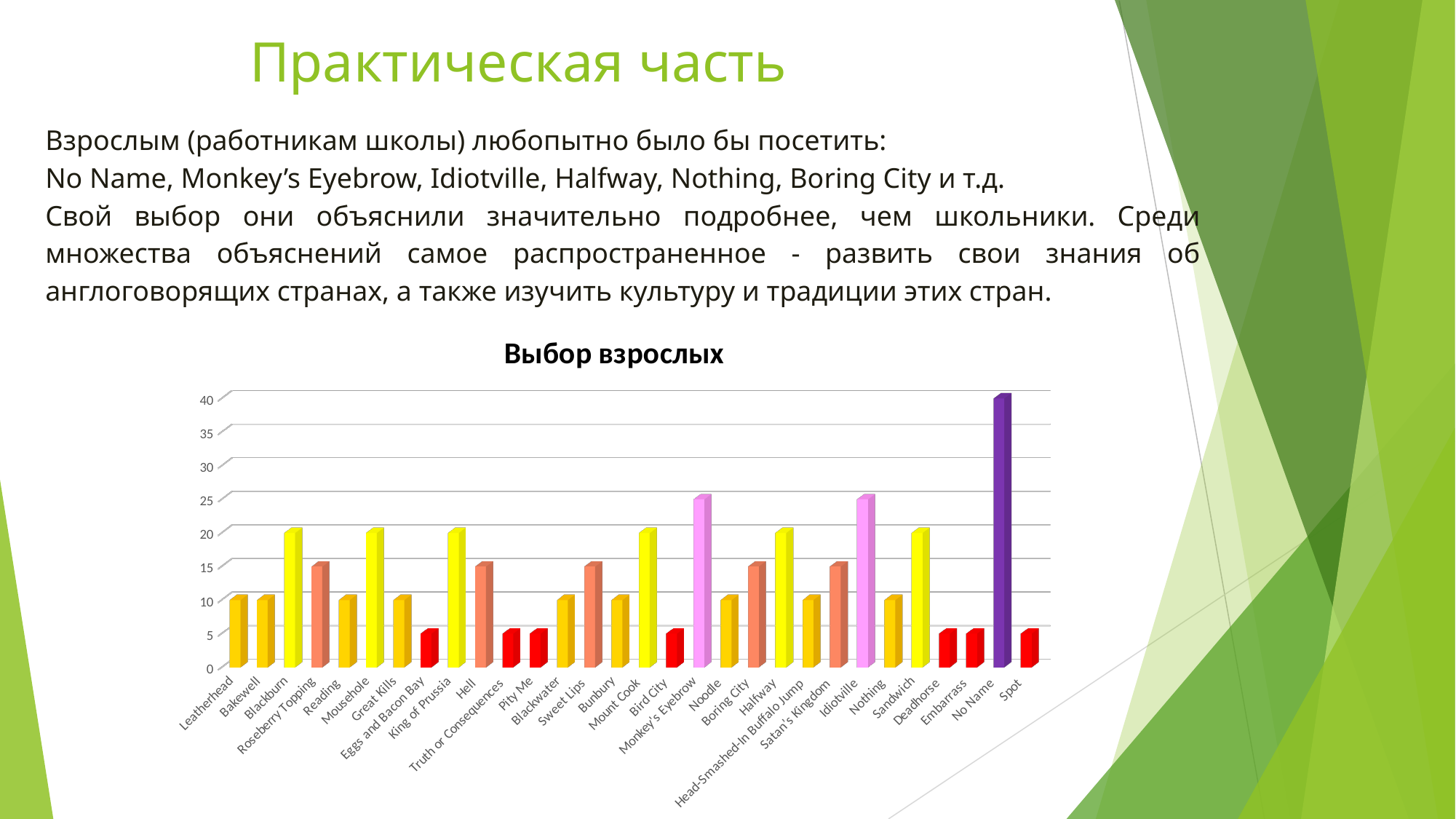
What is the value for Halfway? 20 What is the value for No Name? 40 What is the value for Hell? 15 What is the value for Monkey's Eyebrow? 25 Which category has the highest value in the chart? No Name How many categories are shown on the x axis of the chart? 30 What is the value for Idiotville? 25 What is the title of the chart on the slide? Выбор взрослых What kind of chart is shown on the slide? bar chart Is the value for Pity Me greater or less than 10? less Which is larger, the value for No Name or the value for Idiotville? No Name Is the value for Monkey's Eyebrow greater or less than 20? greater